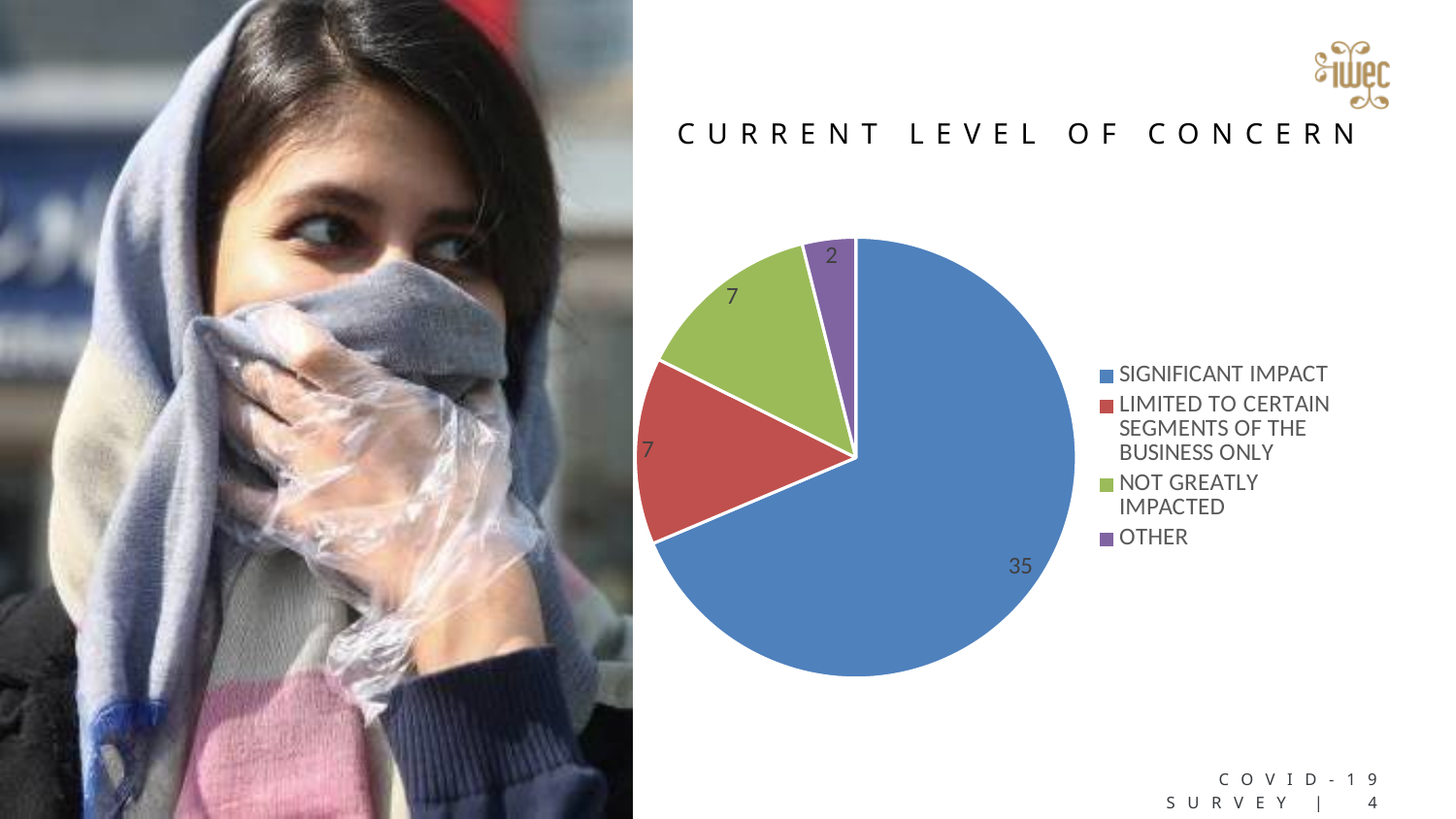
What is the value for NOT GREATLY IMPACTED? 7 How many categories does the pie chart have? 4 What colour is the SIGNIFICANT IMPACT slice? Blue Which category has the smallest slice of the pie? OTHER What is the title of the chart? CURRENT LEVEL OF CONCERN What is the value for SIGNIFICANT IMPACT? 35 What type of chart is shown on the slide? Pie chart What is the difference between the values for SIGNIFICANT IMPACT and NOT GREATLY IMPACTED? 28 What is the value for OTHER? 2 What is the difference between the values for LIMITED TO CERTAIN SEGMENTS OF THE BUSINESS ONLY and OTHER? 5 Which is larger, the value for SIGNIFICANT IMPACT or the value for OTHER? SIGNIFICANT IMPACT Which category has the largest slice of the pie? SIGNIFICANT IMPACT